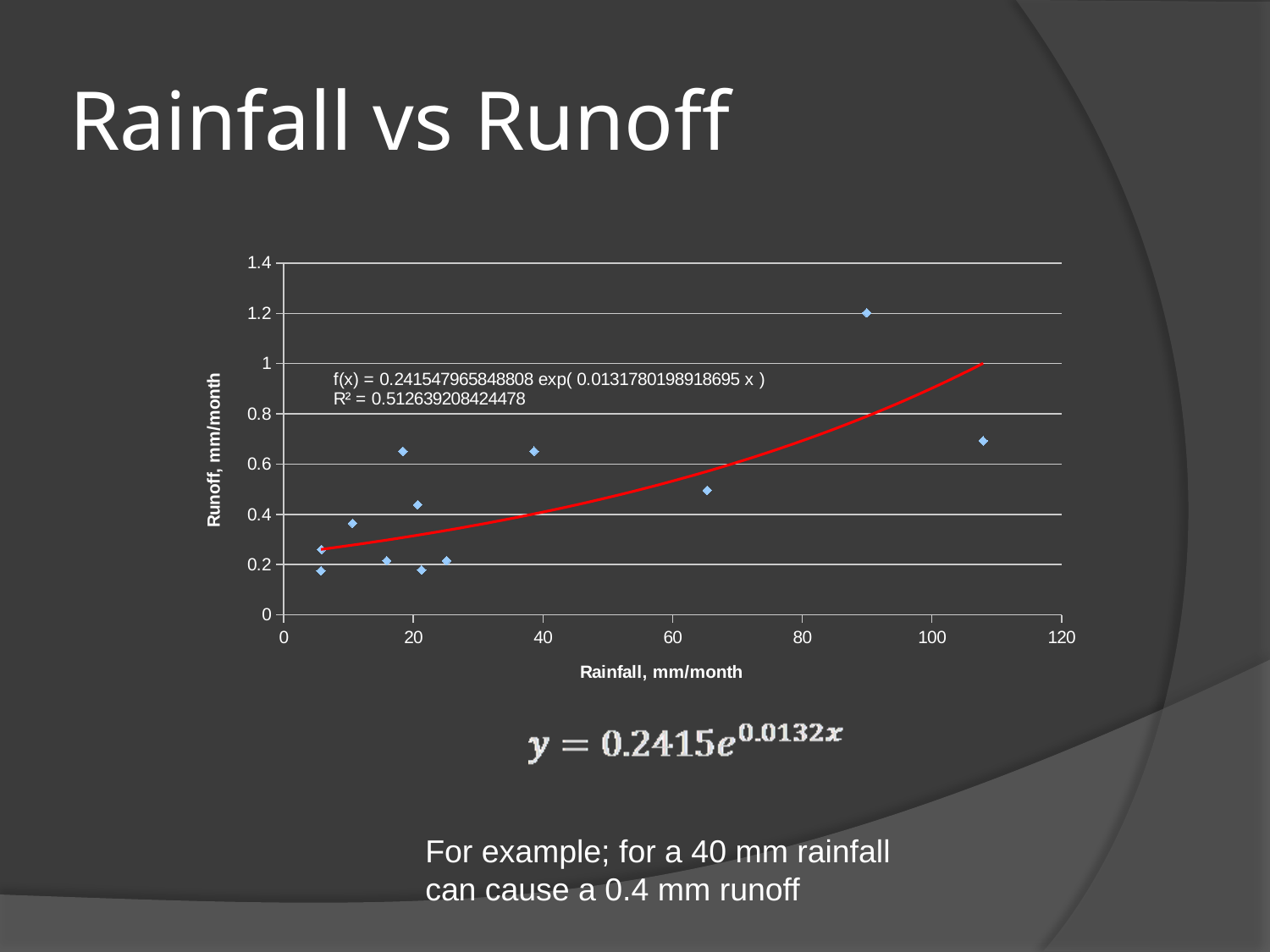
What is the equation of the fitted curve as printed below the chart? y = 0.2415e^(0.0132x) What is the title of the slide's chart? Rainfall vs Runoff What is the highest value shown on the x axis? 120 What R² value is printed on the chart? 0.512639208424478 Does the fitted trendline rise or fall as rainfall increases? Rises Is the runoff value for the point at about 65 mm/month rainfall greater or less than 0.6? less What is the label of the x axis? Rainfall, mm/month Is the runoff value for the point at about 108 mm/month rainfall greater or less than 0.8? less What is the highest value shown on the y axis? 1.4 Is the runoff value for the point at about 90 mm/month rainfall greater or less than 1? greater What kind of chart is shown on the slide? Scatter chart Which point has the highest runoff: the one at about 90 mm/month rainfall or the one at about 108 mm/month rainfall? The one at about 90 mm/month